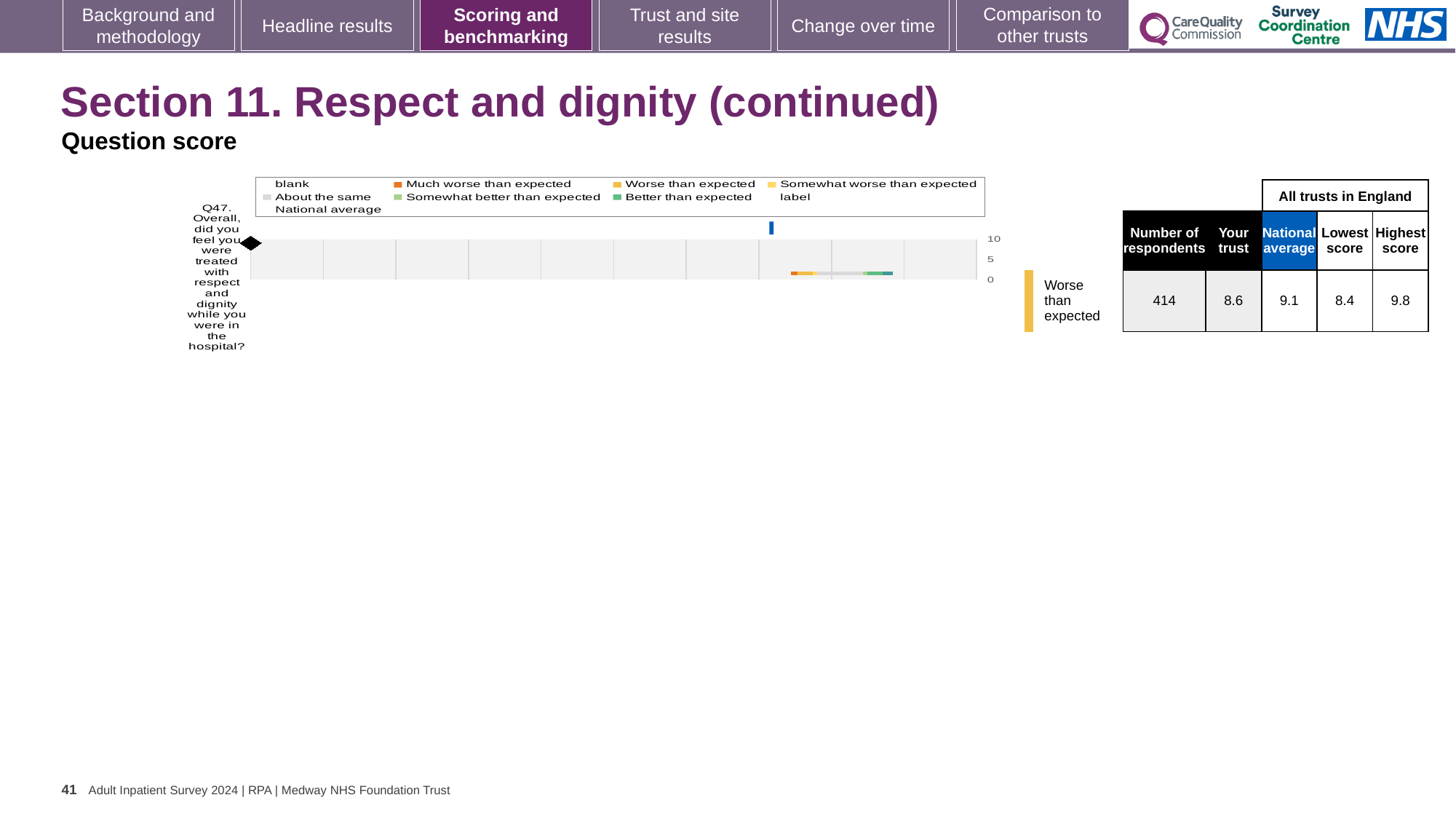
By how much is the national average higher than the trust's score for Q47? 0.5 Which is larger for Q47: the trust's score or the national average? National average What is the highest score among all trusts in England for Q47? 9.8 How many respondents answered Q47? 414 Which benchmarking category is the trust's Q47 score placed in? Worse than expected What is the 'Your trust' score for Q47 (treated with respect and dignity)? 8.6 Is the trust's score for Q47 greater or less than 5? greater What is the highest value shown on the chart's score axis? 10 What is the national average score for Q47? 9.1 How many questions are plotted on the chart? 1 What is the lowest score among all trusts in England for Q47? 8.4 What is the difference between the highest and lowest scores for Q47 across all trusts in England? 1.4